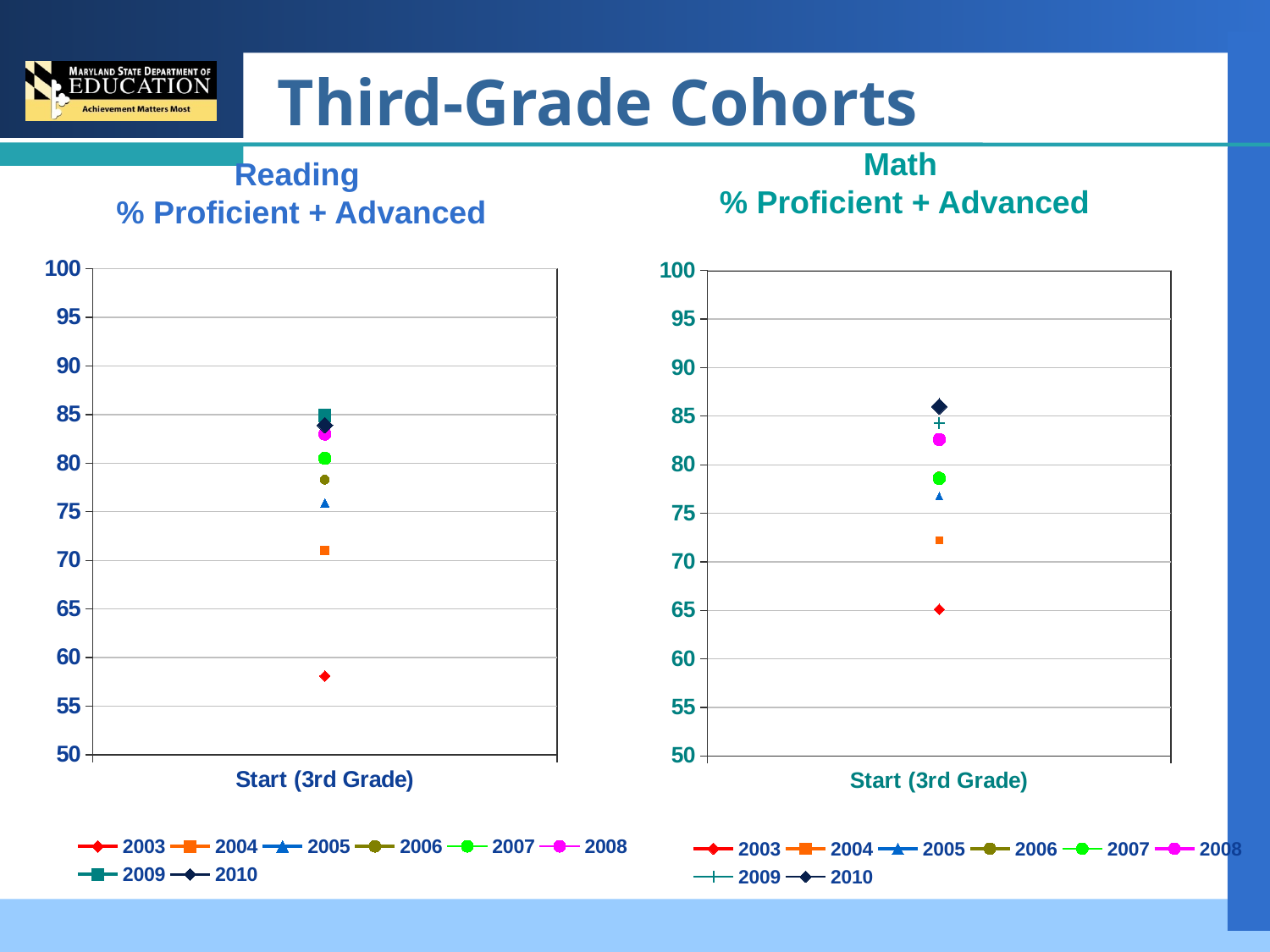
On the Reading chart, is the value for the 2004 cohort greater or less than 70? greater On the Reading chart, which cohort has the higher value, 2003 or 2004? 2004 On the Math chart, is the value for the 2010 cohort greater or less than 85? greater On the Math chart, which cohort has the higher value, 2005 or 2008? 2008 What is the x-axis label on the Reading chart? Start (3rd Grade) On the Math chart, which year's cohort has the lowest % Proficient + Advanced at Start (3rd Grade)? 2003 How many series does the legend of the Reading chart list? 8 On the Reading chart, is the value for the 2003 cohort greater or less than 60? less How many categories are shown on the x axis of the Math chart? 1 On the Math chart, which year's cohort has the highest % Proficient + Advanced at Start (3rd Grade)? 2010 On the Reading chart, which year's cohort has the lowest % Proficient + Advanced at Start (3rd Grade)? 2003